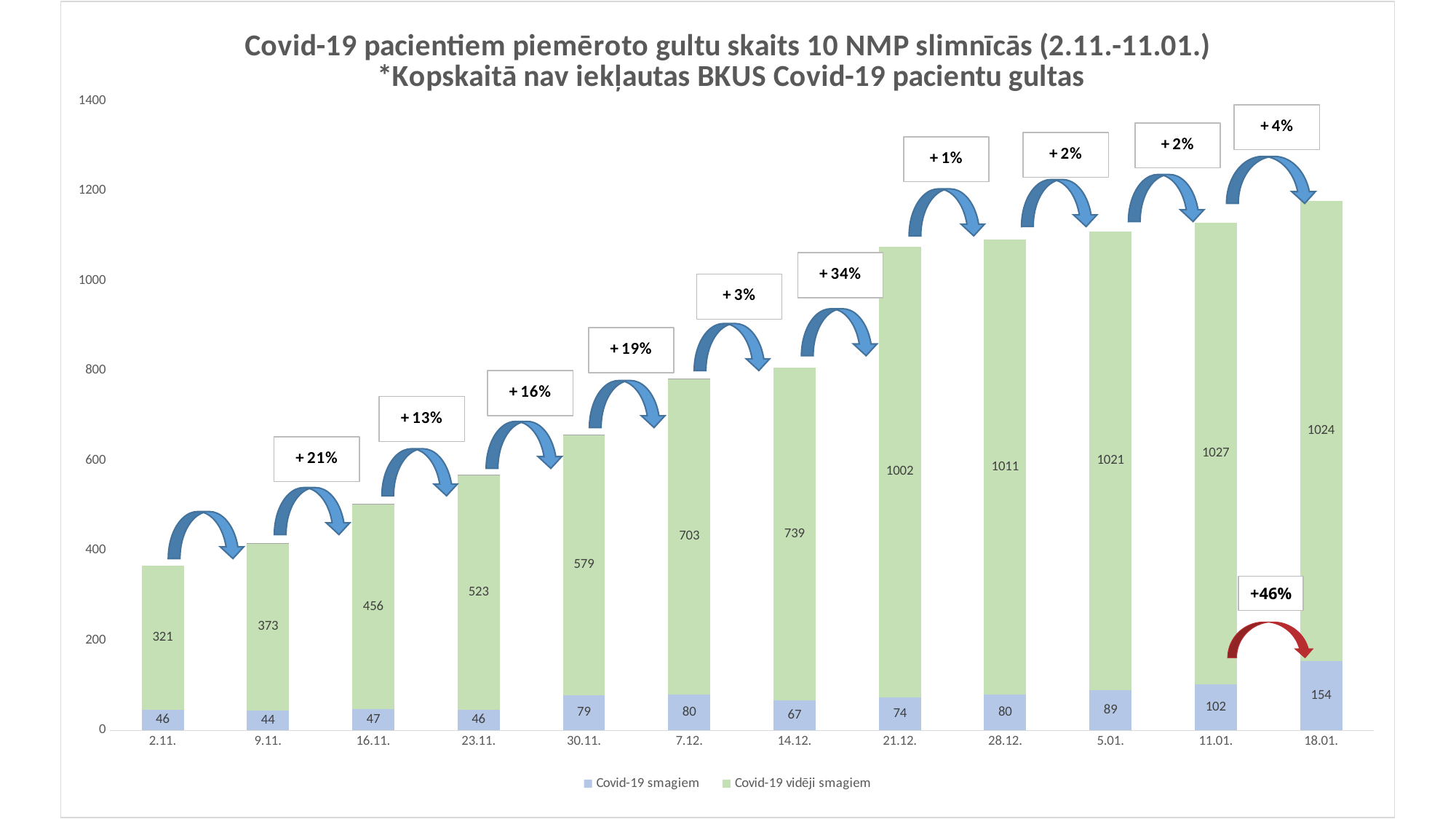
What type of chart is shown on the slide? stacked bar chart How many series does the legend list? 2 What is the total of the stacked bar for 21.12.? 1076 What is the difference between the Covid-19 vidēji smagiem values on 21.12. and 14.12.? 263 What is the value for Covid-19 smagiem on 30.11.? 79 What percentage change is shown in the red label between 11.01. and 18.01.? +46% Which is larger: the Covid-19 smagiem value on 5.01. or on 14.12.? 5.01. What is the value for Covid-19 vidēji smagiem on 7.12.? 703 What is the value for Covid-19 smagiem on 18.01.? 154 On which date is the Covid-19 vidēji smagiem value highest? 11.01. How many dates are shown on the x axis? 12 On which date is the Covid-19 smagiem value lowest? 9.11.